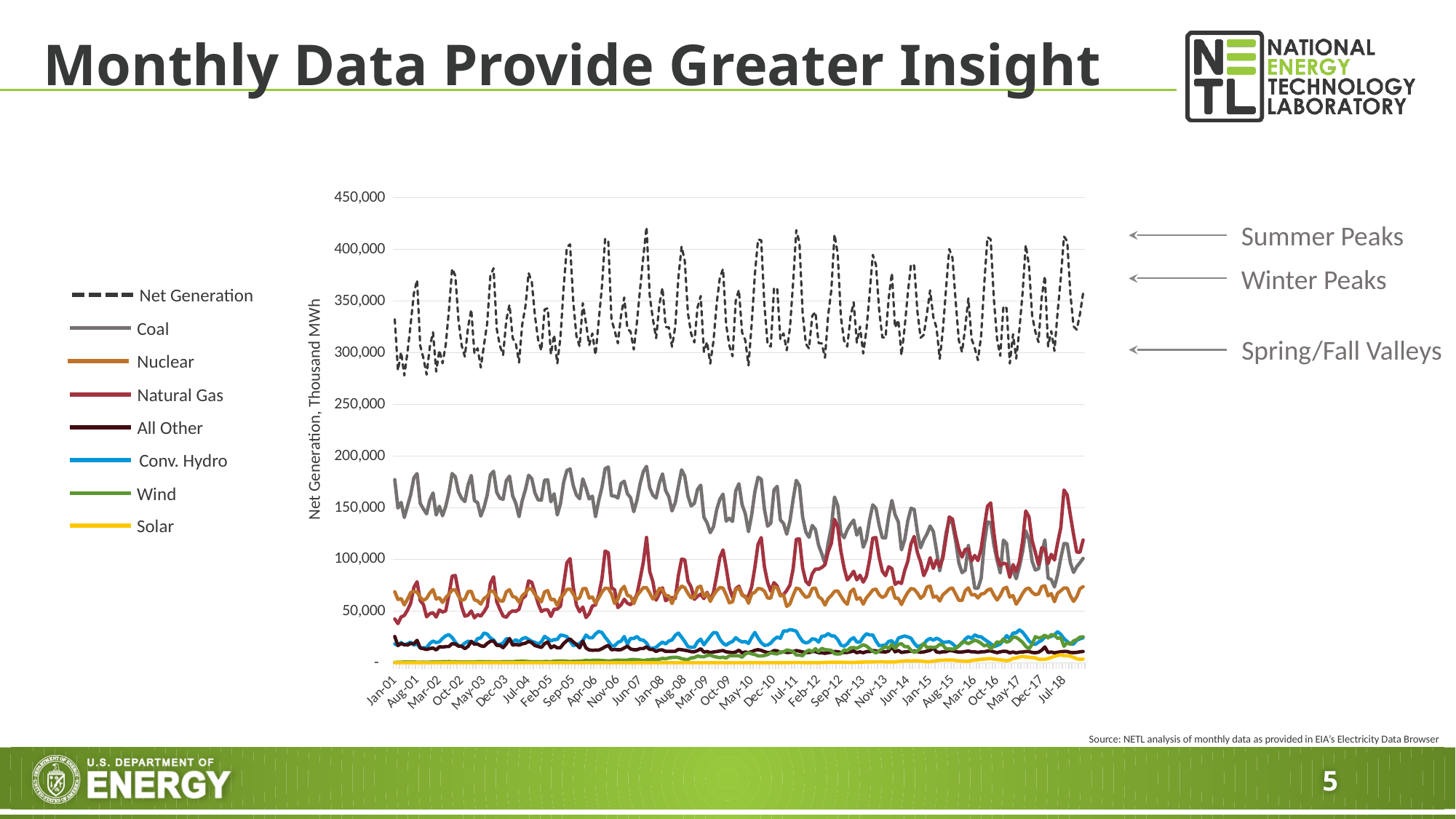
Does the Wind series rise or fall overall from Jan-01 to Jul-18? rise Is the value for Nuclear at Jul-18 greater or less than 100,000? less Which series is drawn as a dashed line in the chart? Net Generation At Jan-01, which is larger, the value for Coal or the value for Natural Gas? Coal How many series does the chart's legend list? 8 What is the label of the vertical axis of the chart? Net Generation, Thousand MWh What kind of chart is shown on the slide? line chart Which series has the highest values throughout the chart? Net Generation Does the Coal series rise or fall overall from Jan-01 to Jul-18? fall Is the value for Net Generation at Jan-01 greater or less than 400,000? less Which series has the lowest values throughout the chart? Solar Does the Natural Gas series rise or fall overall from Jan-01 to Jul-18? rise